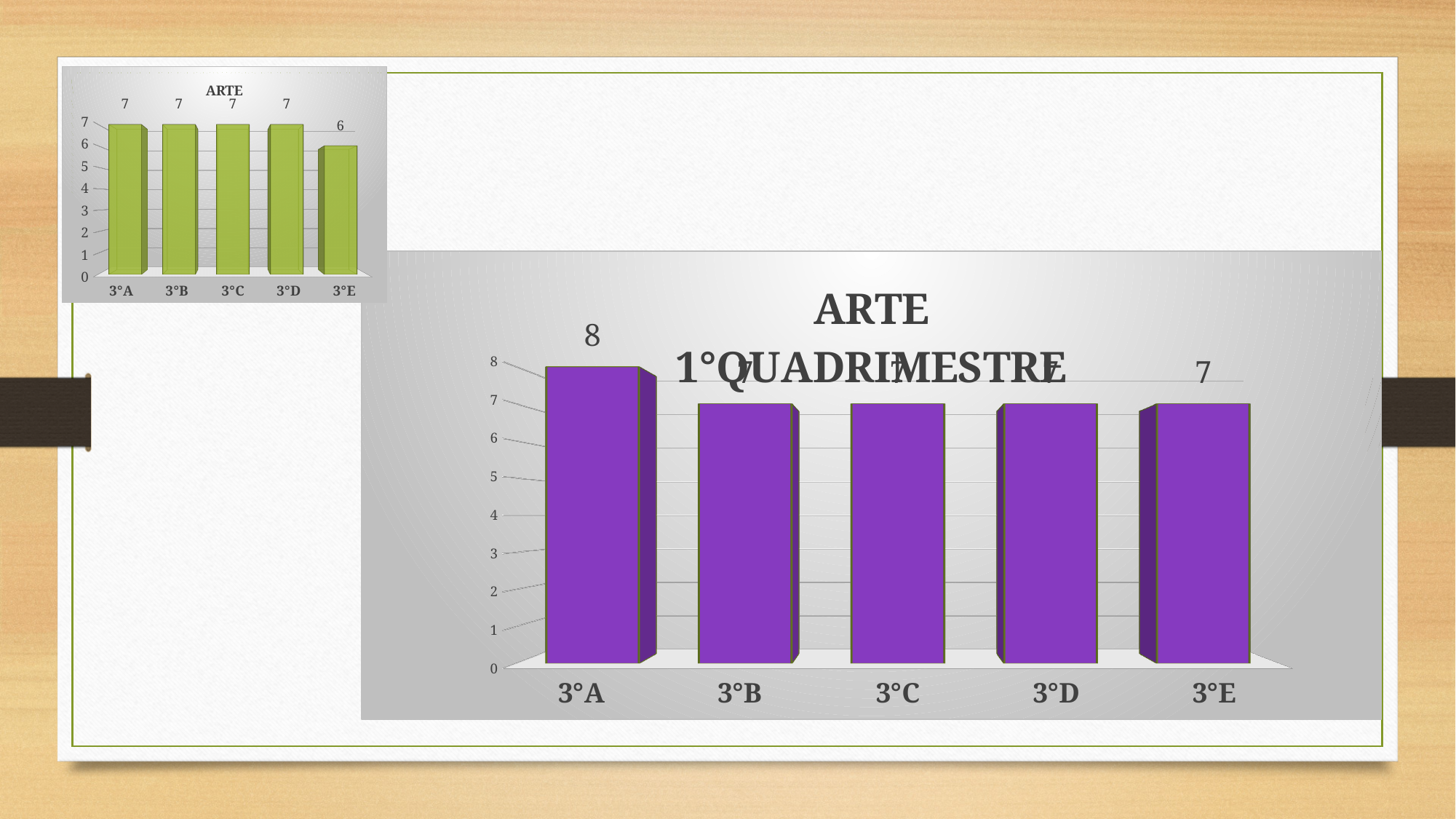
In the large chart titled ARTE 1°QUADRIMESTRE, what is the value for 3°A? 8 In the small chart at the top left titled ARTE, which class has the lowest value? 3°E In the small chart at the top left titled ARTE, what is the value for 3°E? 6 In the large chart titled ARTE 1°QUADRIMESTRE, what is the difference between the values for 3°A and 3°E? 1 In the small chart at the top left titled ARTE, what is the value for 3°A? 7 What colour are the bars in the large chart titled ARTE 1°QUADRIMESTRE? purple In the small chart at the top left titled ARTE, is the value for 3°B larger or smaller than the value for 3°E? larger In the large chart titled ARTE 1°QUADRIMESTRE, what is the value for 3°E? 7 In the large chart titled ARTE 1°QUADRIMESTRE, how many classes are shown on the x axis? 5 What kind of chart is the large chart titled ARTE 1°QUADRIMESTRE? bar chart In the large chart titled ARTE 1°QUADRIMESTRE, which class has the highest value? 3°A In the small chart at the top left titled ARTE, what is the difference between the values for 3°D and 3°E? 1